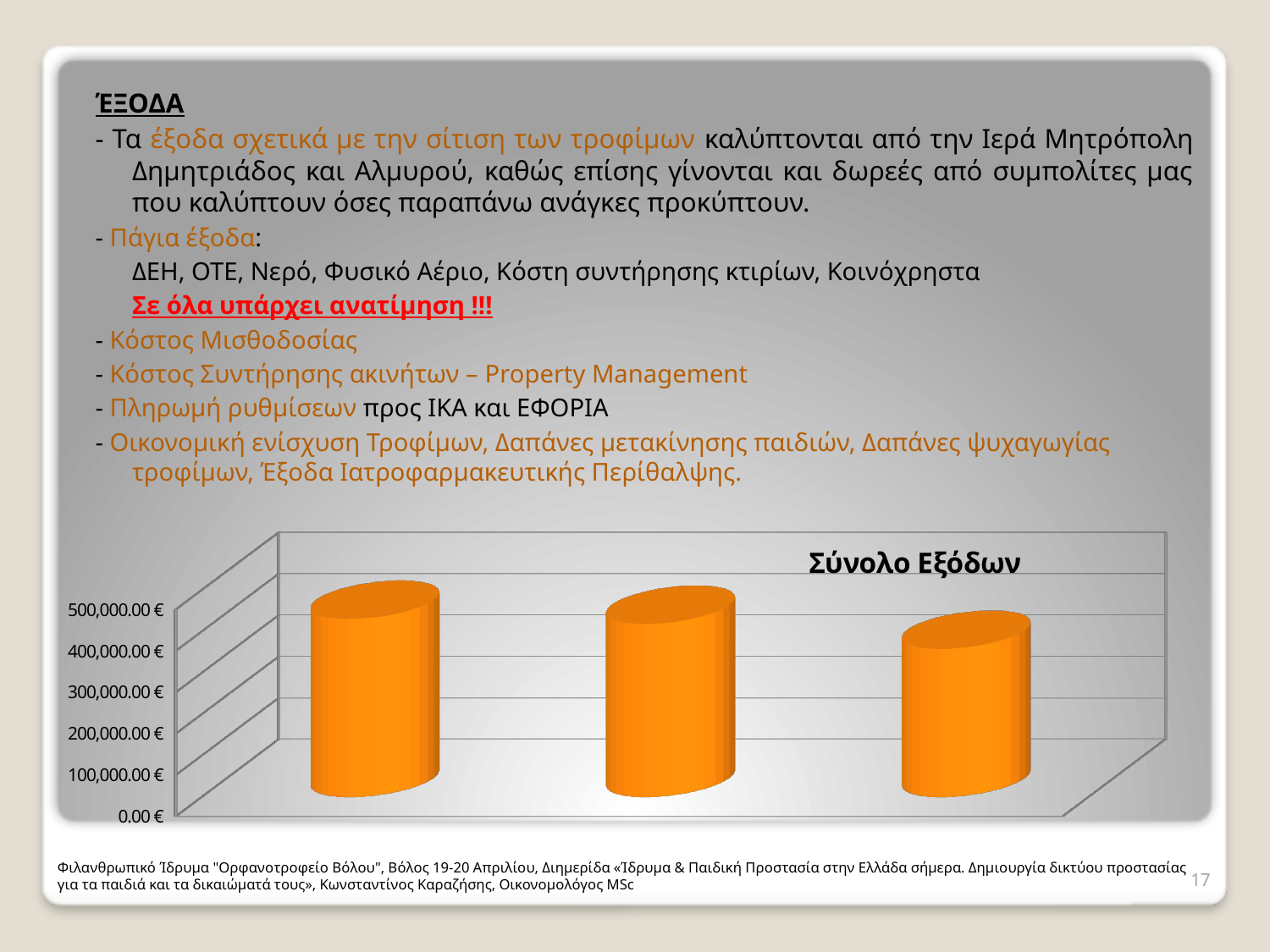
Is the value of the right bar greater or less than 300,000.00 €? greater What kind of chart is shown on the slide? bar chart Which is larger, the left bar or the right bar? left bar Which bar is the shortest in the chart: the left, middle or right one? right Is the value of the middle bar greater or less than 300,000.00 €? greater Which bar is the tallest in the chart: the left, middle or right one? left How many bars are plotted in the chart? 3 Do the bar values rise or fall from left to right across the chart? fall What colour are the bars in the chart? orange Is the value of the right bar greater or less than 500,000.00 €? less What is the title of the chart? Σύνολο Εξόδων